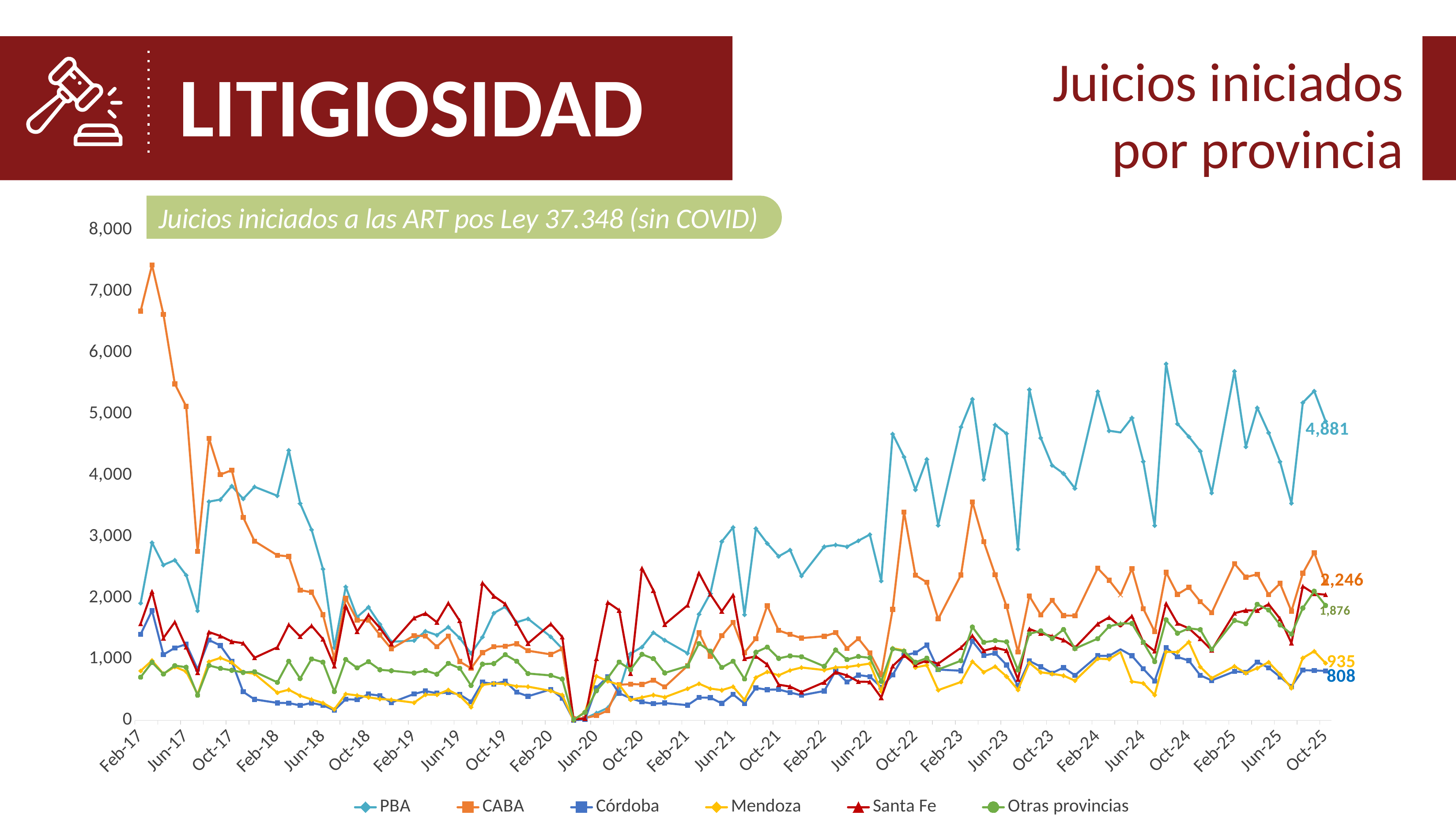
Which series has the highest value at Oct-25? PBA What is the difference between the PBA and CABA values at Oct-25? 2,635 Which series reaches the highest value anywhere on the chart? CABA What kind of chart is shown on the slide? line chart What is the value for Otras provincias at Oct-25? 1,876 What is the value for PBA at Oct-25? 4,881 Is the value for CABA at Feb-17 greater or less than 6,000? greater What is the value for Córdoba at Oct-25? 808 At Oct-25, which is larger: the value for Mendoza or the value for Córdoba? Mendoza What is the value for CABA at Oct-25? 2,246 How many series does the legend list? 6 What is the title of the chart? Juicios iniciados a las ART pos Ley 37.348 (sin COVID)